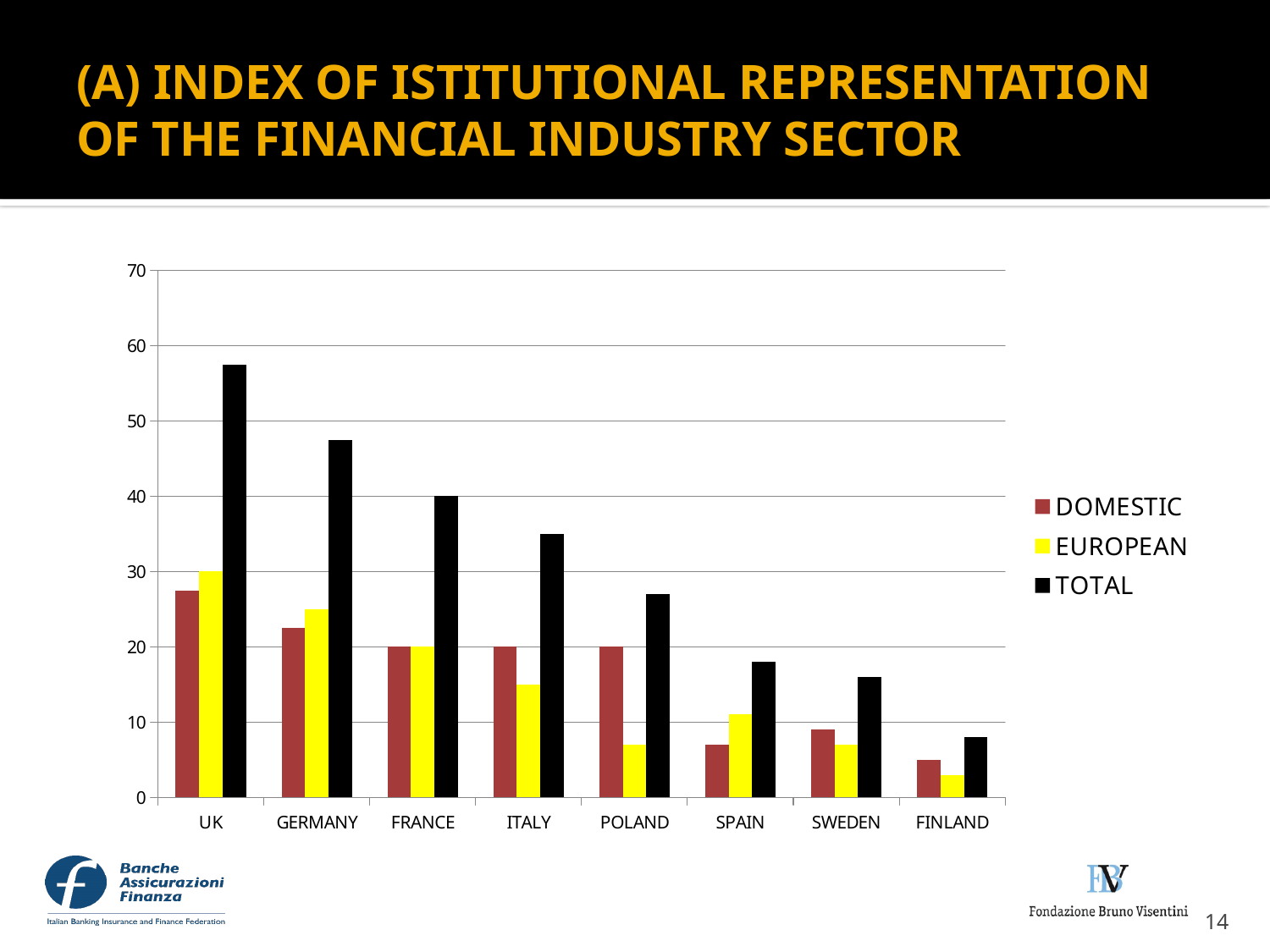
How many series does the legend list? 3 Which country has the highest TOTAL value? UK Is the TOTAL value for UK greater or less than 50? greater Is the DOMESTIC value for GERMANY greater or less than 20? greater What colour are the TOTAL bars? black Which country has the lowest TOTAL value? FINLAND Which is larger, the TOTAL value for GERMANY or the TOTAL value for FRANCE? GERMANY What kind of chart is shown on the slide? bar chart Do the TOTAL values rise or fall moving from UK to FINLAND along the x axis? fall Which is larger for ITALY, the DOMESTIC value or the EUROPEAN value? DOMESTIC How many countries are shown on the x axis? 8 Is the TOTAL value for SPAIN greater or less than 20? less